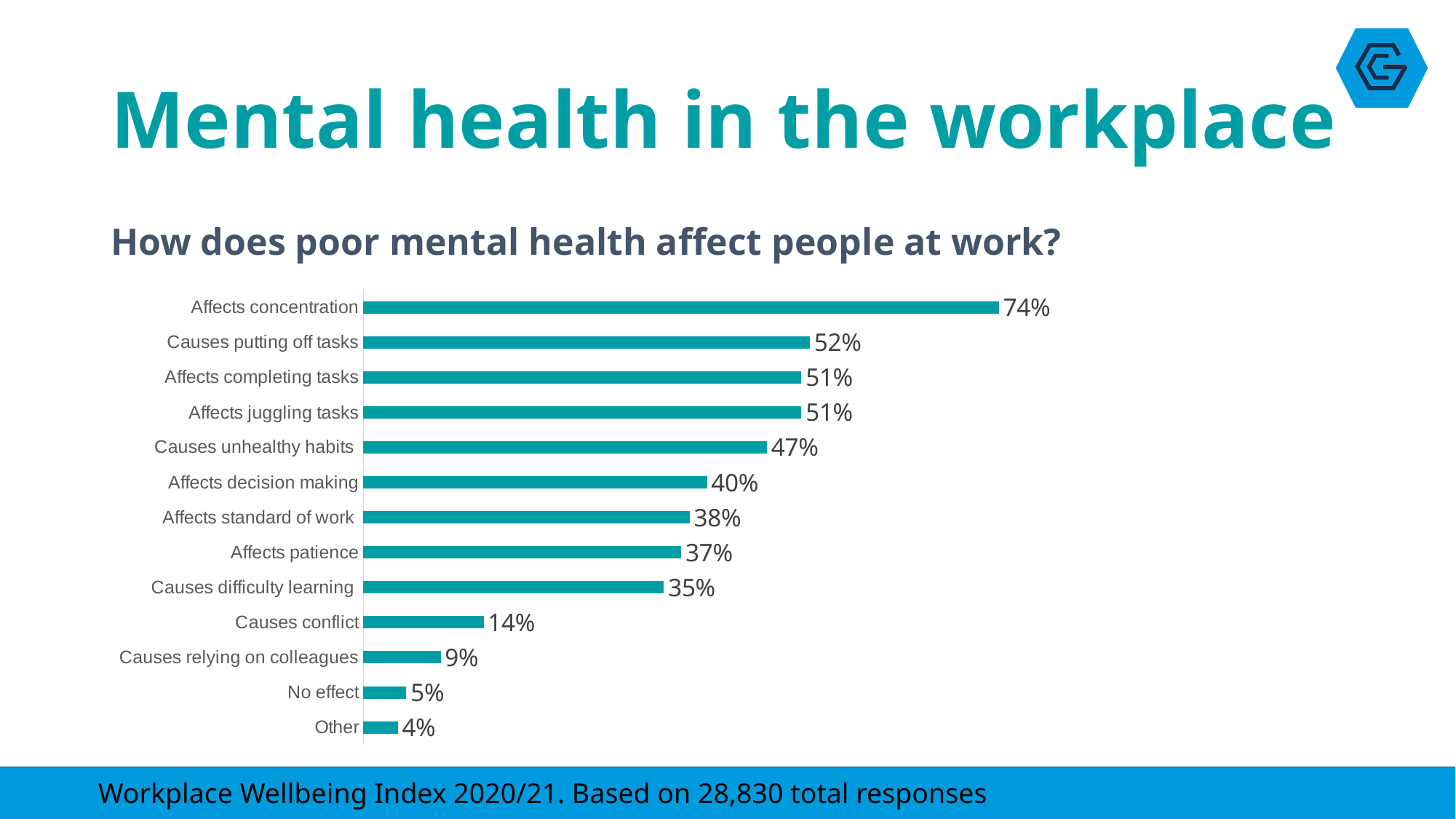
What type of chart is shown on the slide? Bar chart Which is larger: 'Affects patience' or 'Causes difficulty learning'? Affects patience Which category has the highest value? Affects concentration What question does the chart's heading ask? How does poor mental health affect people at work? What is the value for 'Causes relying on colleagues'? 9% What is the difference between 'Affects concentration' and 'Causes putting off tasks'? 22 percentage points What is the difference between 'Affects decision making' and 'Causes conflict'? 26 percentage points Which category has the lowest value? Other What is the value for 'Causes unhealthy habits'? 47% How many categories are shown in the chart? 13 Which is larger: 'No effect' or 'Causes relying on colleagues'? Causes relying on colleagues What percentage of respondents said poor mental health affects concentration? 74%